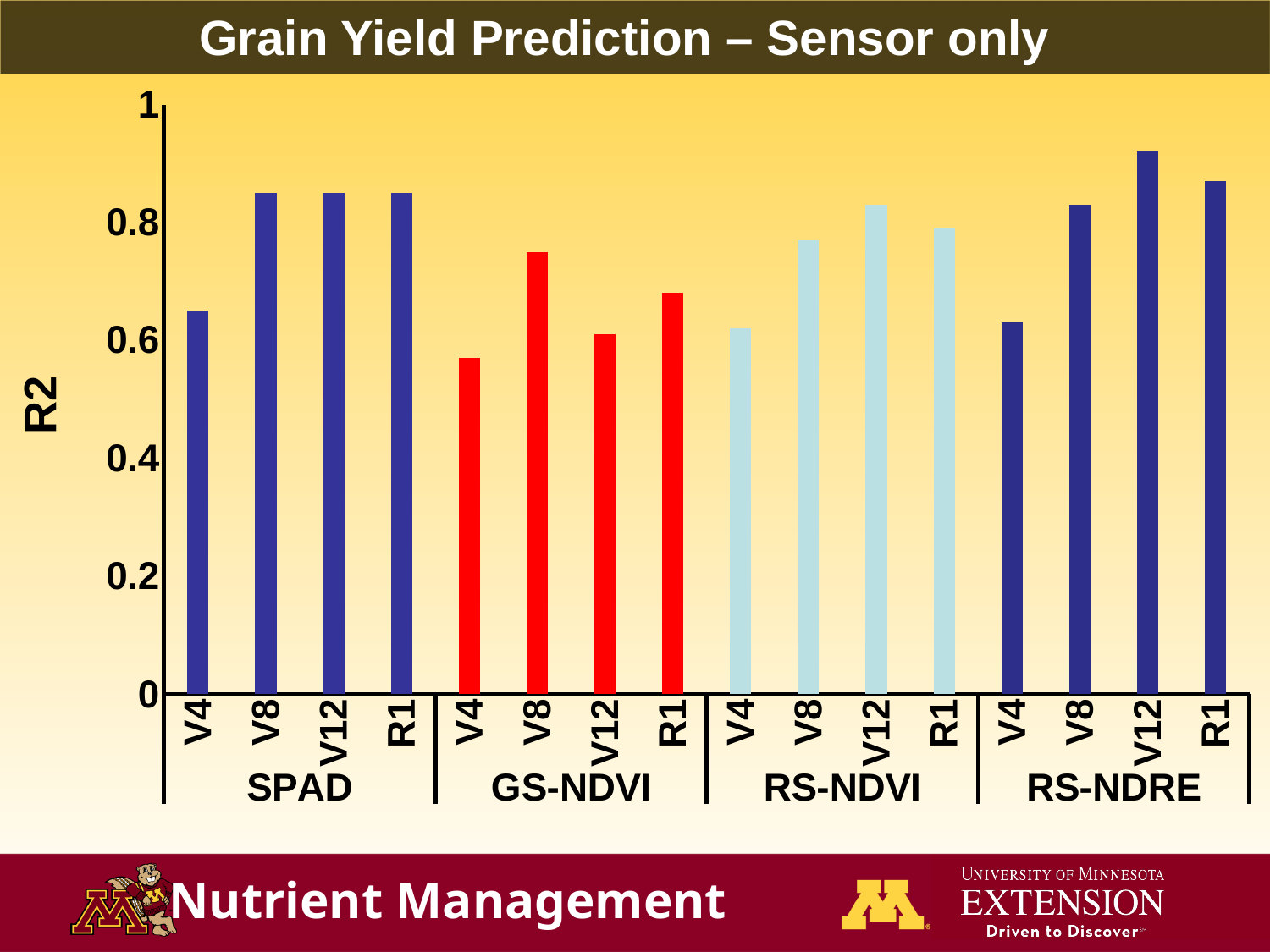
Is the R2 value for RS-NDRE V12 greater or less than 0.8? greater Is the R2 value for GS-NDVI V4 greater or less than 0.6? less Which bar has the highest R2 value on the chart? RS-NDRE V12 Is the R2 value for SPAD V8 greater or less than 0.8? greater What kind of chart is shown on the slide? bar chart Within the GS-NDVI group, which growth stage has the highest R2? V8 How many sensor groups are shown along the x axis? 4 What is the title of the chart? Grain Yield Prediction – Sensor only How many bars are plotted in total on the chart? 16 Which has a higher R2 value, GS-NDVI V8 or RS-NDVI V8? RS-NDVI V8 Which bar has the lowest R2 value on the chart? GS-NDVI V4 What is the label on the vertical axis? R2